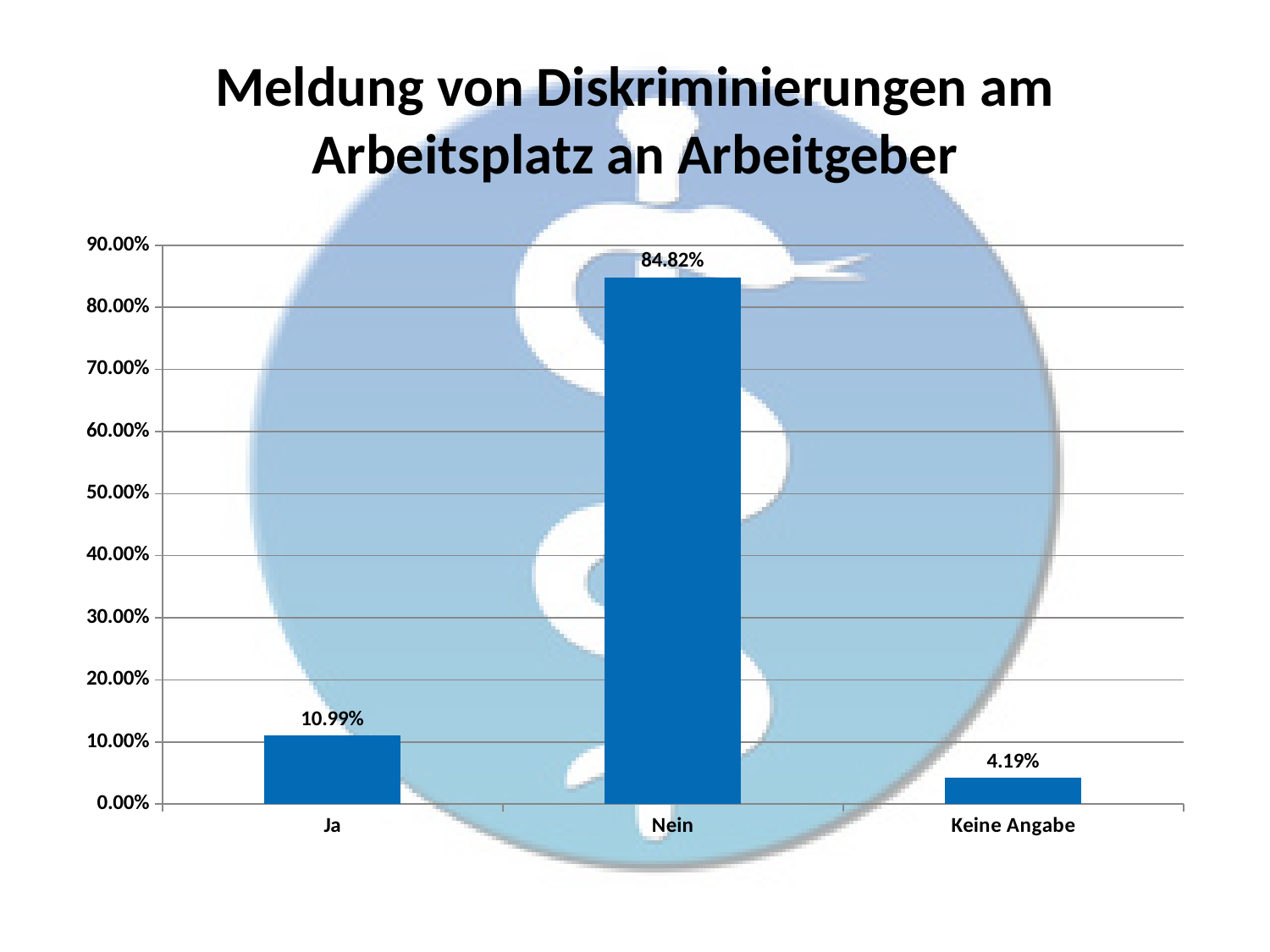
What is the value for "Ja"? 10.99% Which is larger, the value for "Ja" or the value for "Keine Angabe"? Ja Which category has the highest value? Nein How many categories are shown on the x axis? 3 What is the difference between the values for "Nein" and "Ja"? 73.83% What is the value for "Nein"? 84.82% Which category has the lowest value? Keine Angabe What kind of chart is shown on the slide? bar chart What is the difference between the values for "Ja" and "Keine Angabe"? 6.80% What is the value for "Keine Angabe"? 4.19% What is the title of the chart? Meldung von Diskriminierungen am Arbeitsplatz an Arbeitgeber Is the value for "Nein" greater or less than 80.00%? greater